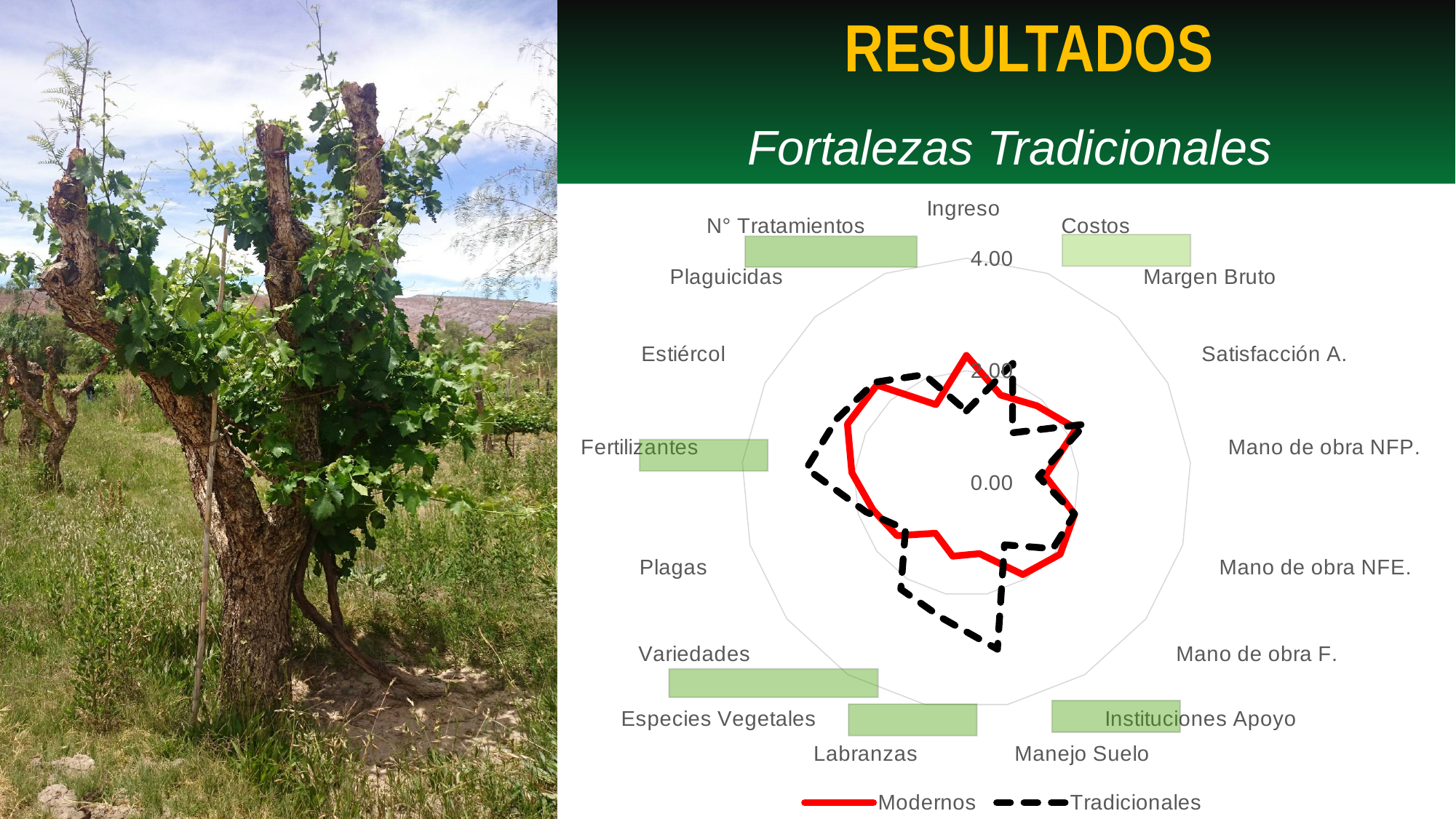
How many categories (axes) does the radar chart have? 17 How many series does the chart legend list? 2 What is the highest value shown on the radar chart's axis scale? 4.00 Is the Modernos value for Mano de obra NFP. greater or less than 2.00? less Is the Tradicionales value for Labranzas greater or less than 2.00? greater Is the Tradicionales value for Fertilizantes greater or less than 2.00? greater Which series is drawn with the red solid line? Modernos Which series has the larger value for Fertilizantes, Modernos or Tradicionales? Tradicionales Which series has the larger value for Labranzas, Modernos or Tradicionales? Tradicionales What kind of chart is shown on the slide? Radar chart